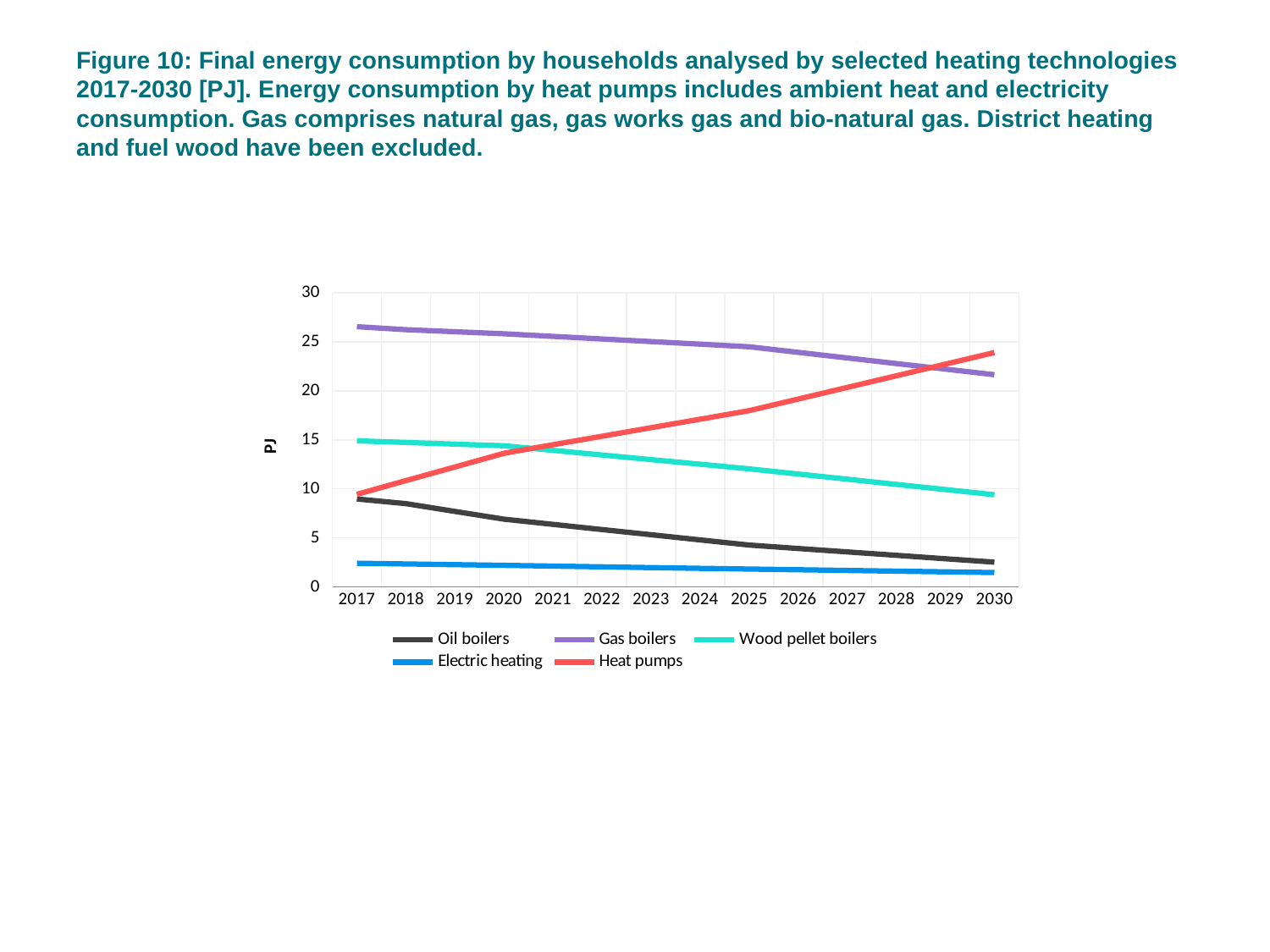
Do the values for Oil boilers rise or fall from 2017 to 2030? Fall Which series has the highest value in 2017? Gas boilers How many years are shown along the x axis? 14 What is the label on the vertical axis? PJ Which series has the highest value in 2030? Heat pumps Which series has the lowest value in 2030? Electric heating Is the value for Oil boilers in 2030 greater or less than 5? less What kind of chart is shown on the slide? Line chart In 2025, which is larger: Heat pumps or Wood pellet boilers? Heat pumps How many series does the legend list? 5 Do the values for Heat pumps rise or fall from 2017 to 2030? Rise Is the value for Gas boilers in 2017 greater or less than 25? greater